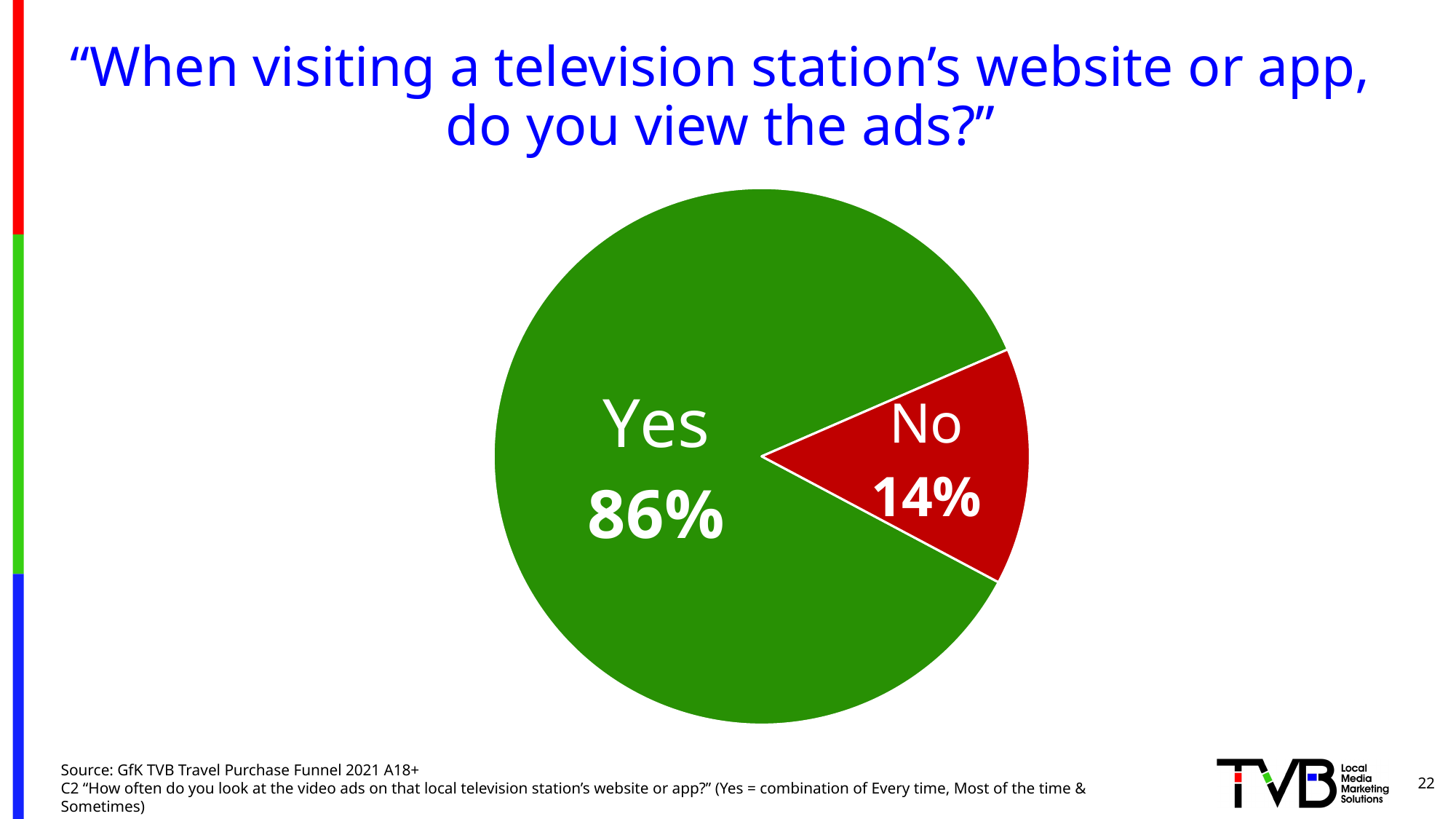
What colour is the No slice? red What is the difference in percentage points between the Yes and No slices? 72 Which response has the smallest share of the pie? No What percentage of respondents answered Yes? 86% What kind of chart is shown on the slide? pie chart How many slices does the pie chart have? 2 Which response has the largest share of the pie? Yes Is the share for No greater or less than 50%? less What percentage of respondents answered No? 14% Which slice is larger, Yes or No? Yes What share of the pie does the Yes slice represent? 86% What colour is the Yes slice? green